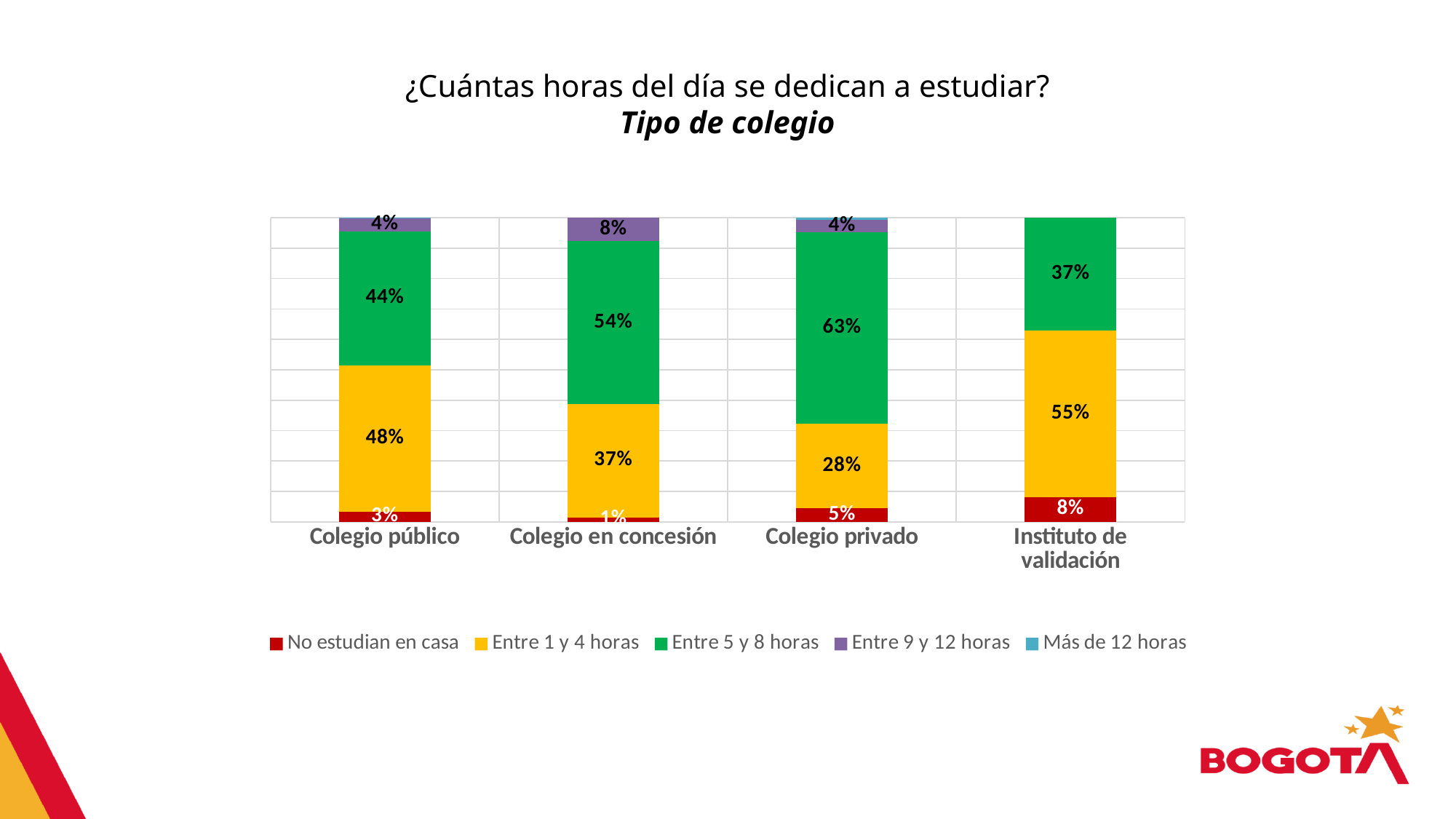
What is the value for 'Entre 9 y 12 horas' for Colegio en concesión? 8% Which type of school has the highest value for 'Entre 5 y 8 horas'? Colegio privado Which colour represents 'Entre 1 y 4 horas' in the chart? Yellow What is the value for 'Entre 5 y 8 horas' for Colegio privado? 63% Which type of school has the lowest value for 'No estudian en casa'? Colegio en concesión What percentage of Instituto de validación students do not study at home ('No estudian en casa')? 8% How many series does the legend list? 5 What is the difference between the 'Entre 1 y 4 horas' values for Instituto de validación and Colegio privado? 27% Which is larger: the 'Entre 5 y 8 horas' value for Colegio público or for Colegio en concesión? Colegio en concesión What percentage of Colegio público students study between 1 and 4 hours? 48% What kind of chart is shown on the slide? Stacked bar chart How many types of school are shown on the x axis? 4